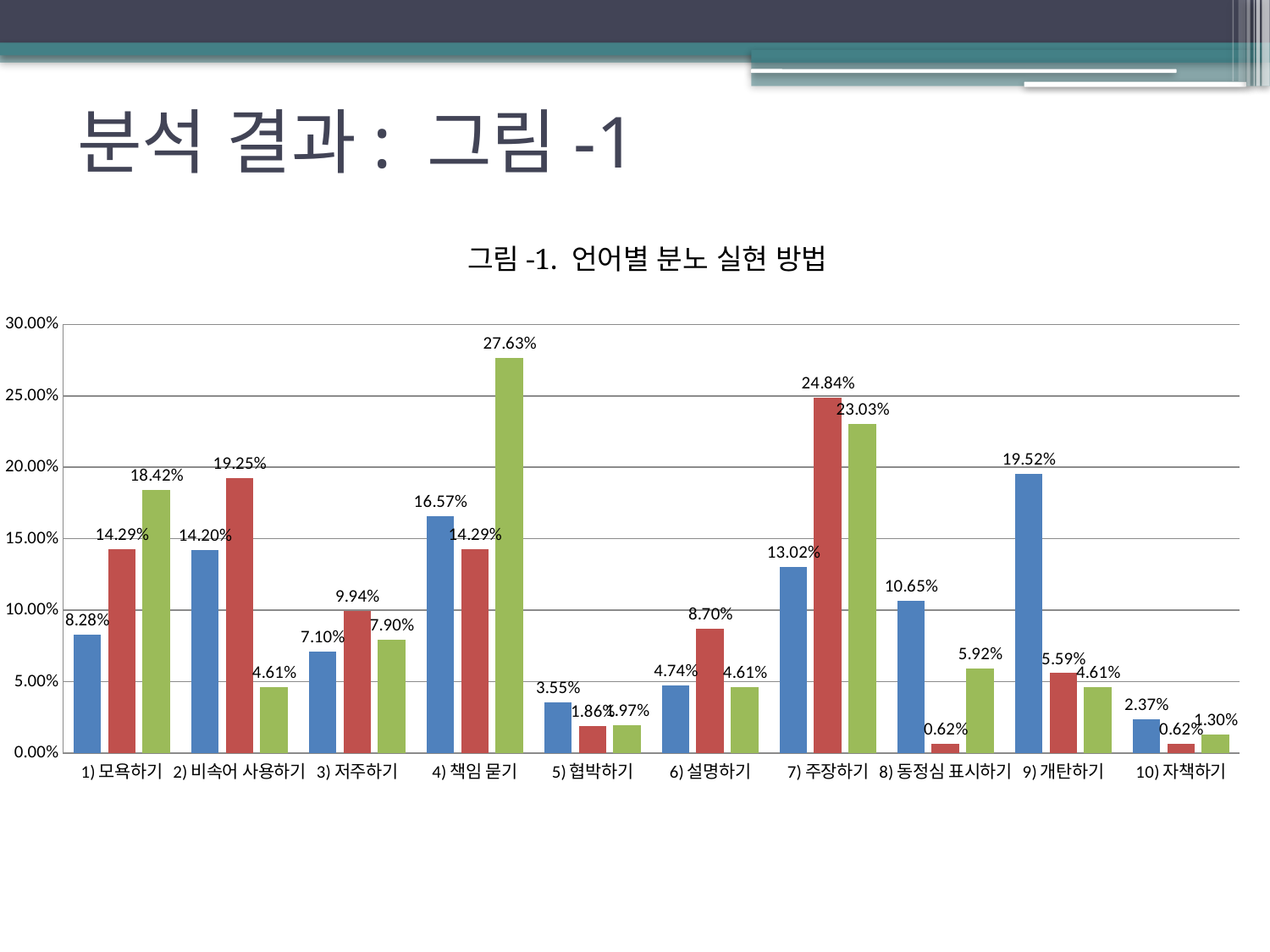
Is the value of the green bar for 7) 주장하기 greater or less than 20.00%? greater What is the title of the chart? 그림 -1. 언어별 분노 실현 방법 What is the difference between the red bar and the blue bar for 7) 주장하기? 11.82% What is the value of the blue bar for 1) 모욕하기? 8.28% What is the value of the red bar for 7) 주장하기? 24.84% What kind of chart is shown on the slide? bar chart What is the value of the green bar for 4) 책임 묻기? 27.63% Which category has the highest blue bar? 9) 개탄하기 Which category has the lowest green bar? 10) 자책하기 How many categories are shown on the x axis? 10 What is the value of the blue bar for 9) 개탄하기? 19.52% Which is larger for 2) 비속어 사용하기, the blue bar or the red bar? the red bar